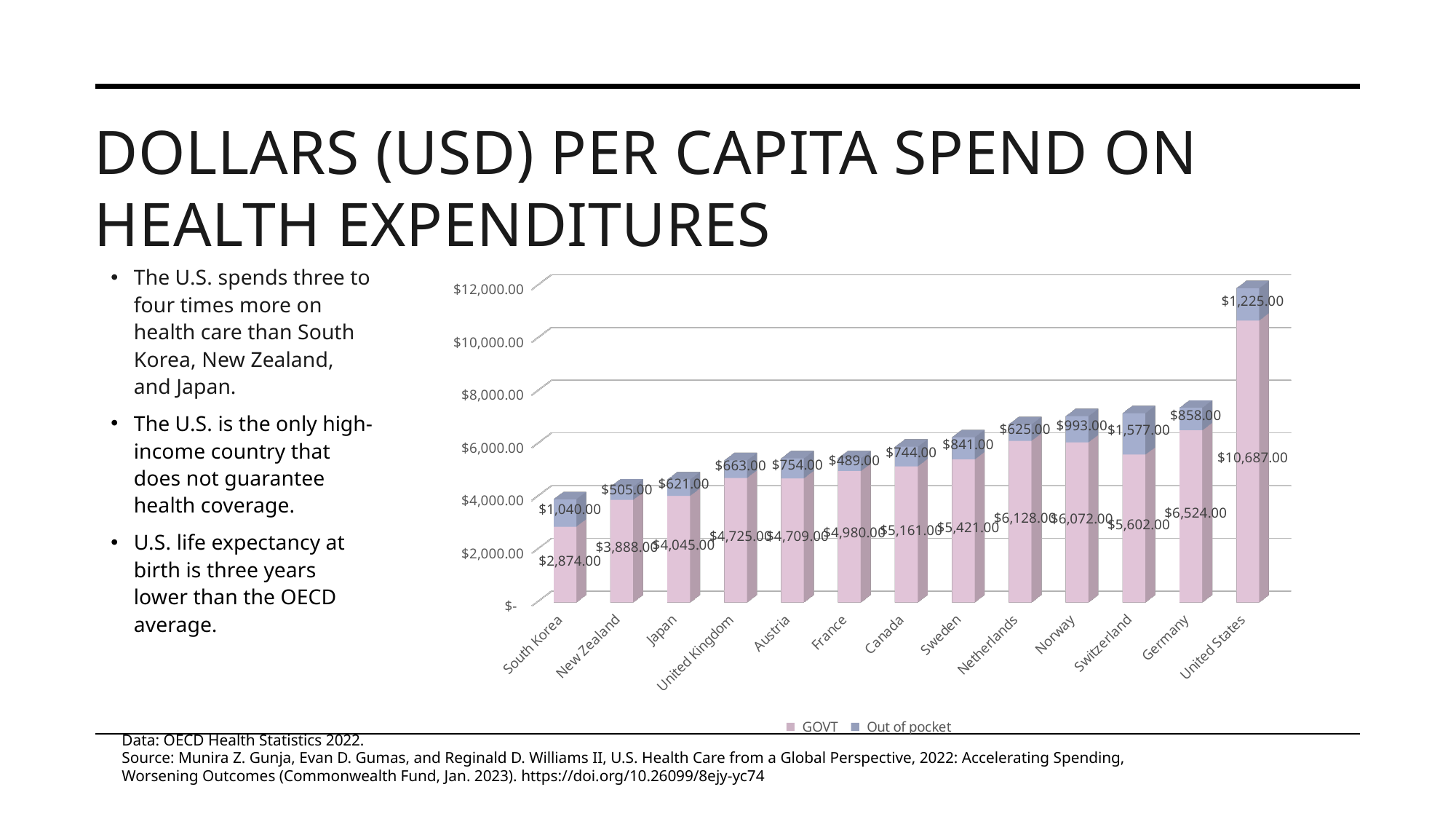
What is the Out of pocket value for Switzerland? $1,577.00 What is the GOVT value for the United States? $10,687.00 What kind of chart is shown on the slide? Stacked bar chart What is the GOVT value for South Korea? $2,874.00 How many series does the legend list? 2 Which country has the lowest Out of pocket value? France What is the total of the stacked bar for South Korea? $3,914.00 What is the difference between the GOVT values for Germany and Japan? $2,479.00 How many countries are shown on the x axis? 13 Which country has the highest GOVT value? United States What is the total of the stacked bar for the United States? $11,912.00 Which has a larger Out of pocket value, Norway or Sweden? Norway